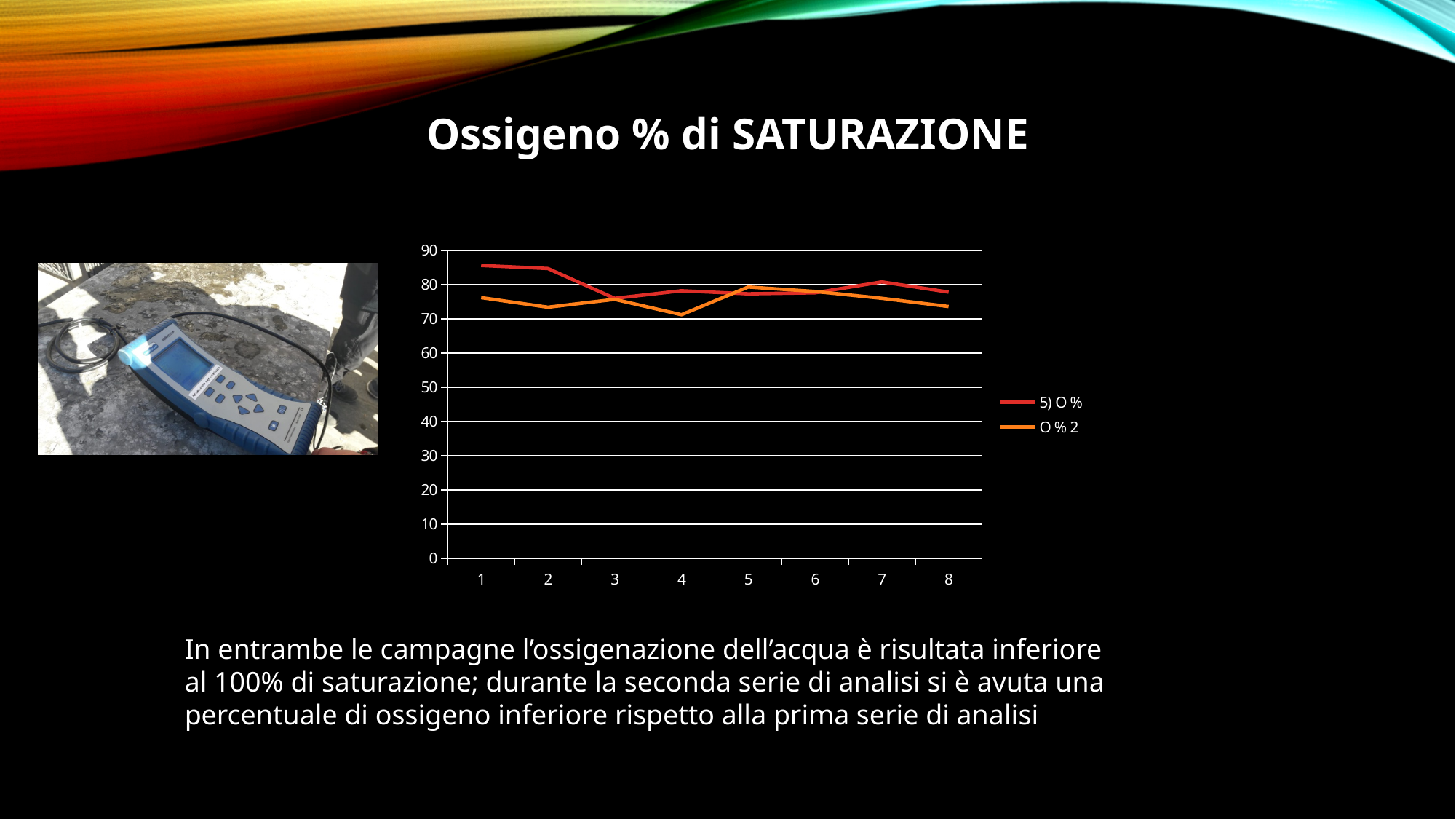
Is the value of the series 5) O % at point 1 greater or less than 80? greater Does the series 5) O % rise or fall from point 1 to point 4? fall What is the title of the chart? Ossigeno % di SATURAZIONE Is the value of the series O % 2 at point 2 greater or less than 80? less Is the value of the series 5) O % at point 4 greater or less than 70? greater At point 1, which series has the larger value, 5) O % or O % 2? 5) O % What kind of chart is shown on the slide? line chart At which x-axis point does the series O % 2 reach its lowest value? 4 How many series does the legend list? 2 How many points are plotted along the x axis for each series? 8 What are the two series names shown in the legend? 5) O % and O % 2